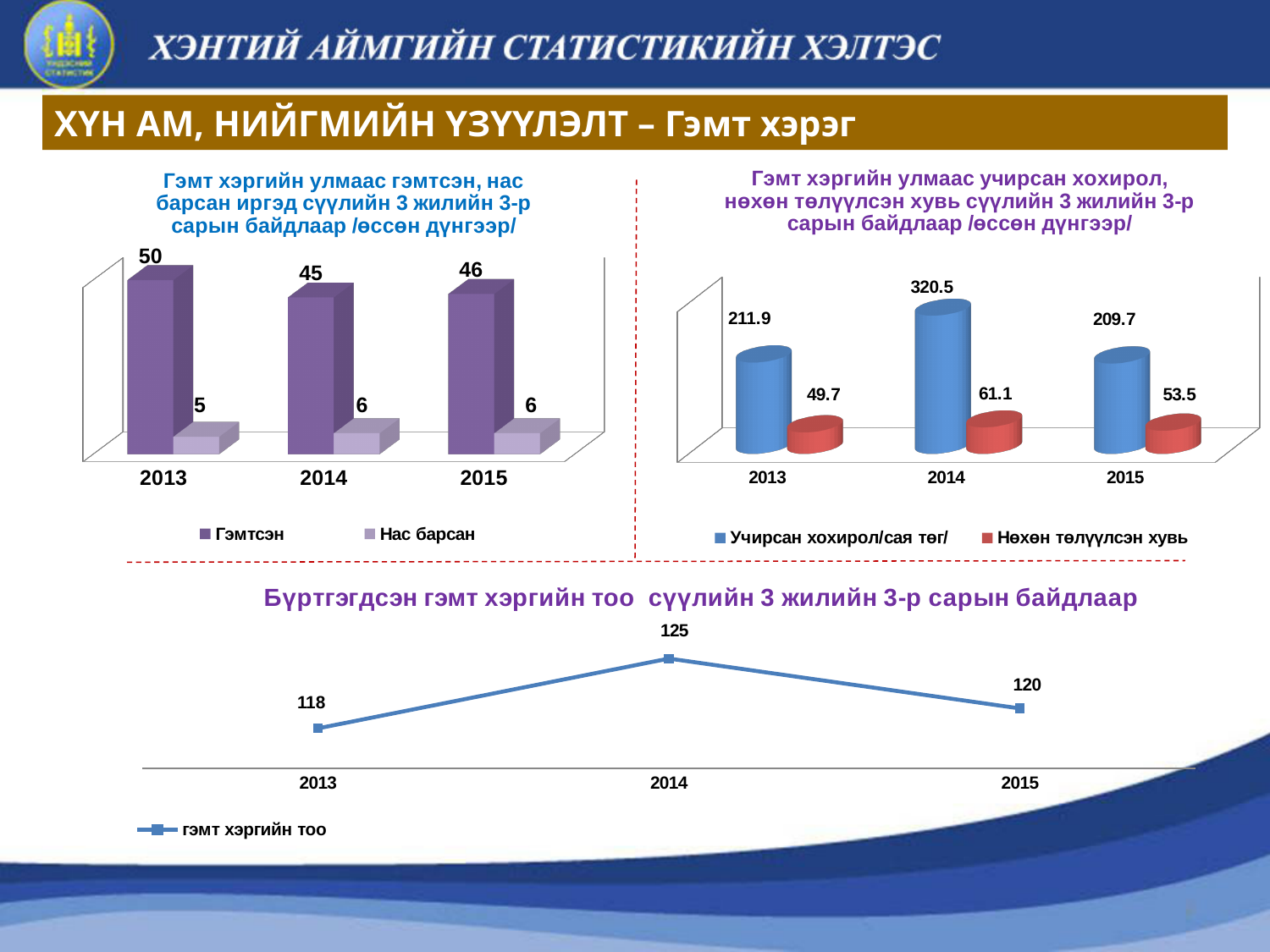
In the top-right chart, what is the value for Нөхөн төлүүлсэн хувь in 2013? 49.7 In the top-left chart, what is the value for Нас барсан in 2015? 6 In the bottom chart, what is the difference between the values for 2014 and 2013? 7 What kind of chart is the bottom chart? Line chart In the top-right chart, which year has the lowest value for Учирсан хохирол/сая төг/? 2015 In the top-right chart, how many series does the legend list? 2 In the bottom chart, what is the value for 2014? 125 In the top-left chart, which year has the highest value for Гэмтсэн? 2013 In the top-left chart, what is the value for Гэмтсэн in 2013? 50 In the bottom chart, how many data points are plotted? 3 In the top-right chart, what is the value for Учирсан хохирол/сая төг/ in 2014? 320.5 In the top-left chart, what is the difference between the Гэмтсэн values for 2013 and 2014? 5